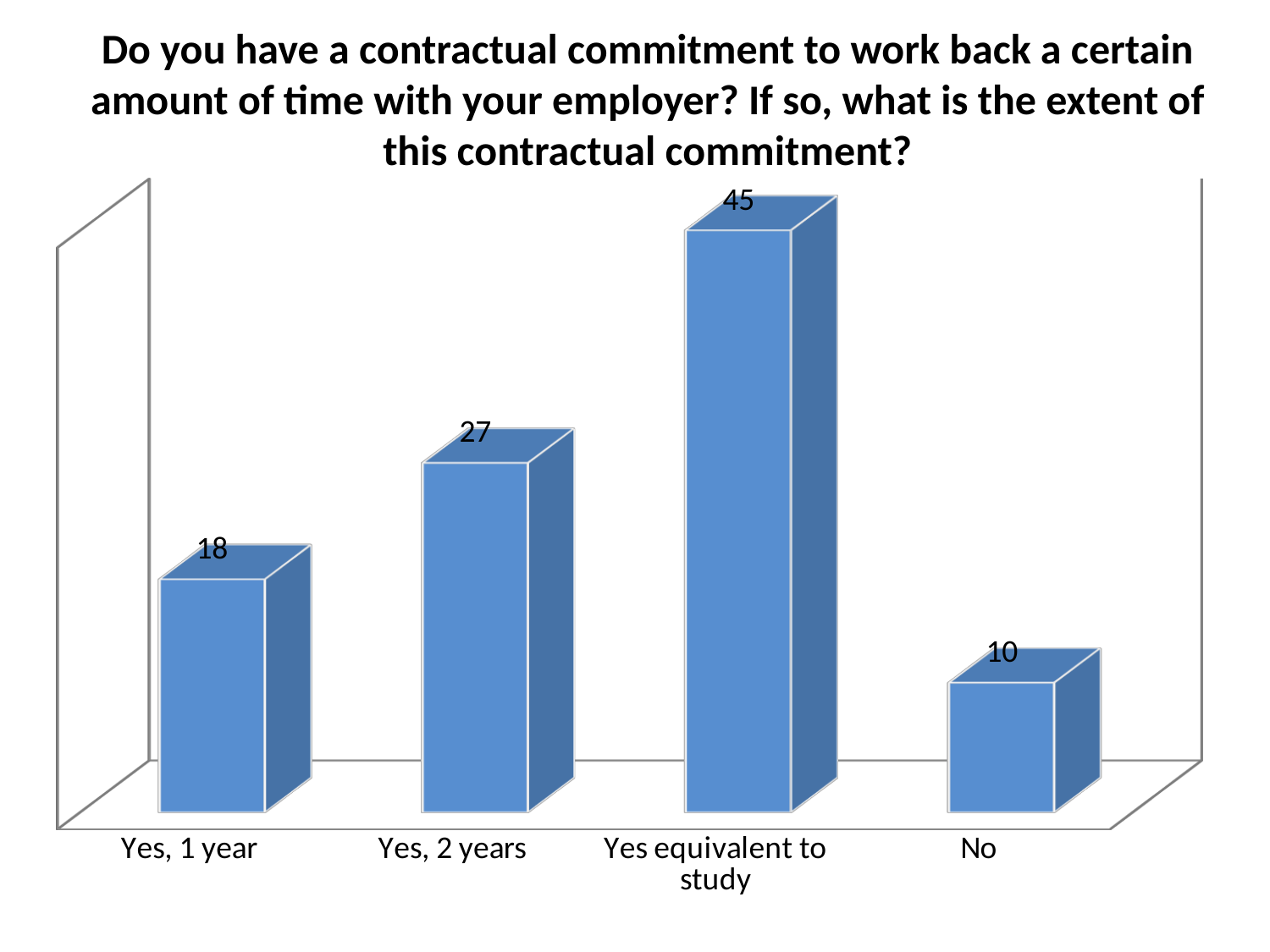
How many categories are shown on the chart? 4 Which category has the highest value? Yes equivalent to study What is the value for "Yes equivalent to study"? 45 What is the difference between the values for "Yes equivalent to study" and "Yes, 2 years"? 18 What is the difference between the values for "Yes, 1 year" and "No"? 8 What kind of chart is shown on the slide? Bar chart What is the value for "No"? 10 Which category has the lowest value? No What is the value for "Yes, 1 year"? 18 What is the value for "Yes, 2 years"? 27 Which is larger, the value for "Yes, 2 years" or the value for "Yes, 1 year"? Yes, 2 years What is the total of all four values shown on the chart? 100